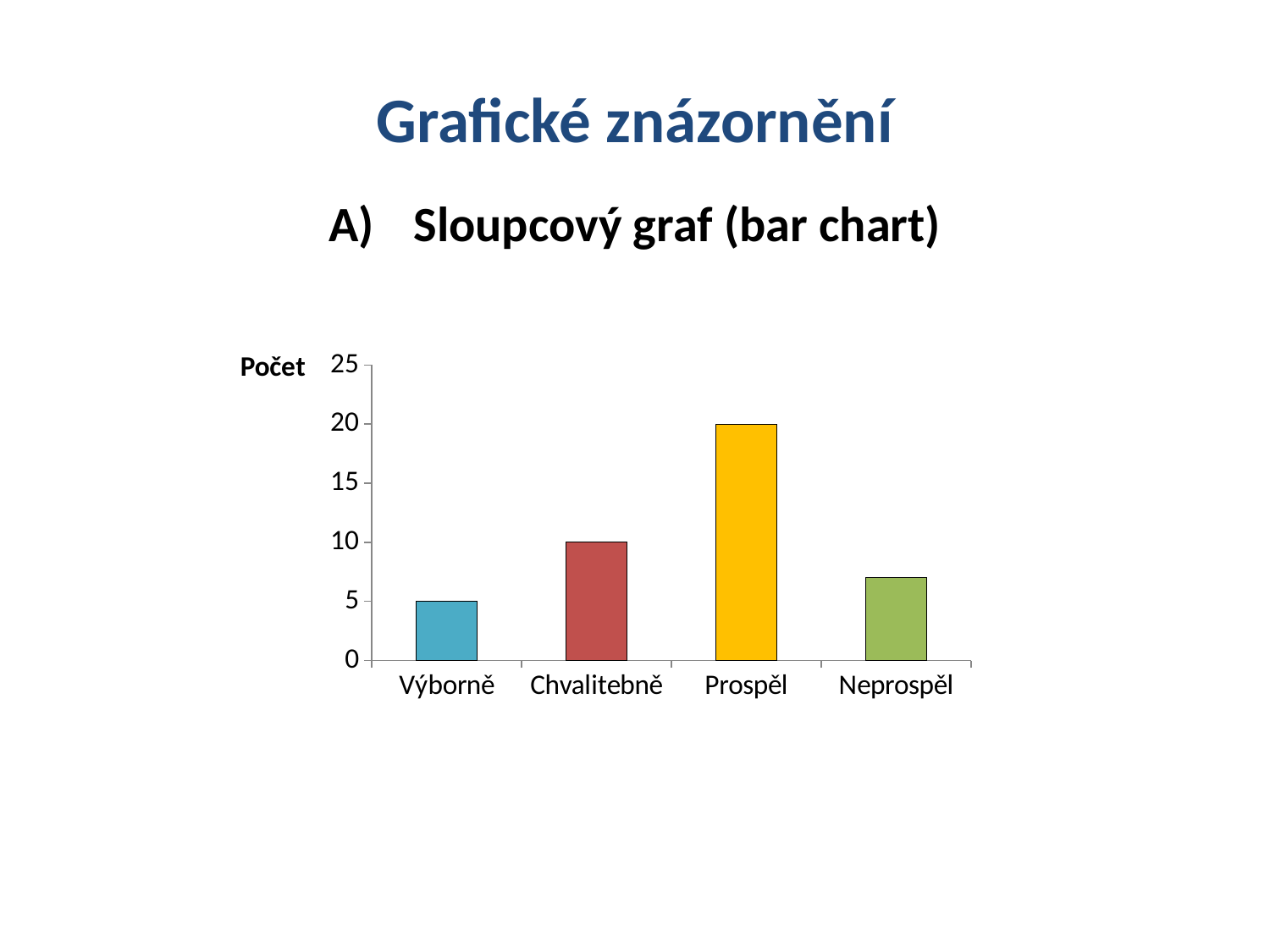
How many categories are shown on the x axis of the chart? 4 Which is larger, the value for Neprospěl or the value for Chvalitebně? Chvalitebně Which category has the lowest bar in the chart? Výborně What is the difference between the values for Prospěl and Chvalitebně? 10 What kind of chart is shown on the slide? bar chart What is the value for Chvalitebně in the chart? 10 Is the value for Neprospěl greater or less than 5? greater Which category has the highest bar in the chart? Prospěl What is the value for Prospěl in the chart? 20 What is the value for Výborně in the chart? 5 What is the label on the vertical axis of the chart? Počet Is the value for Neprospěl greater or less than 10? less